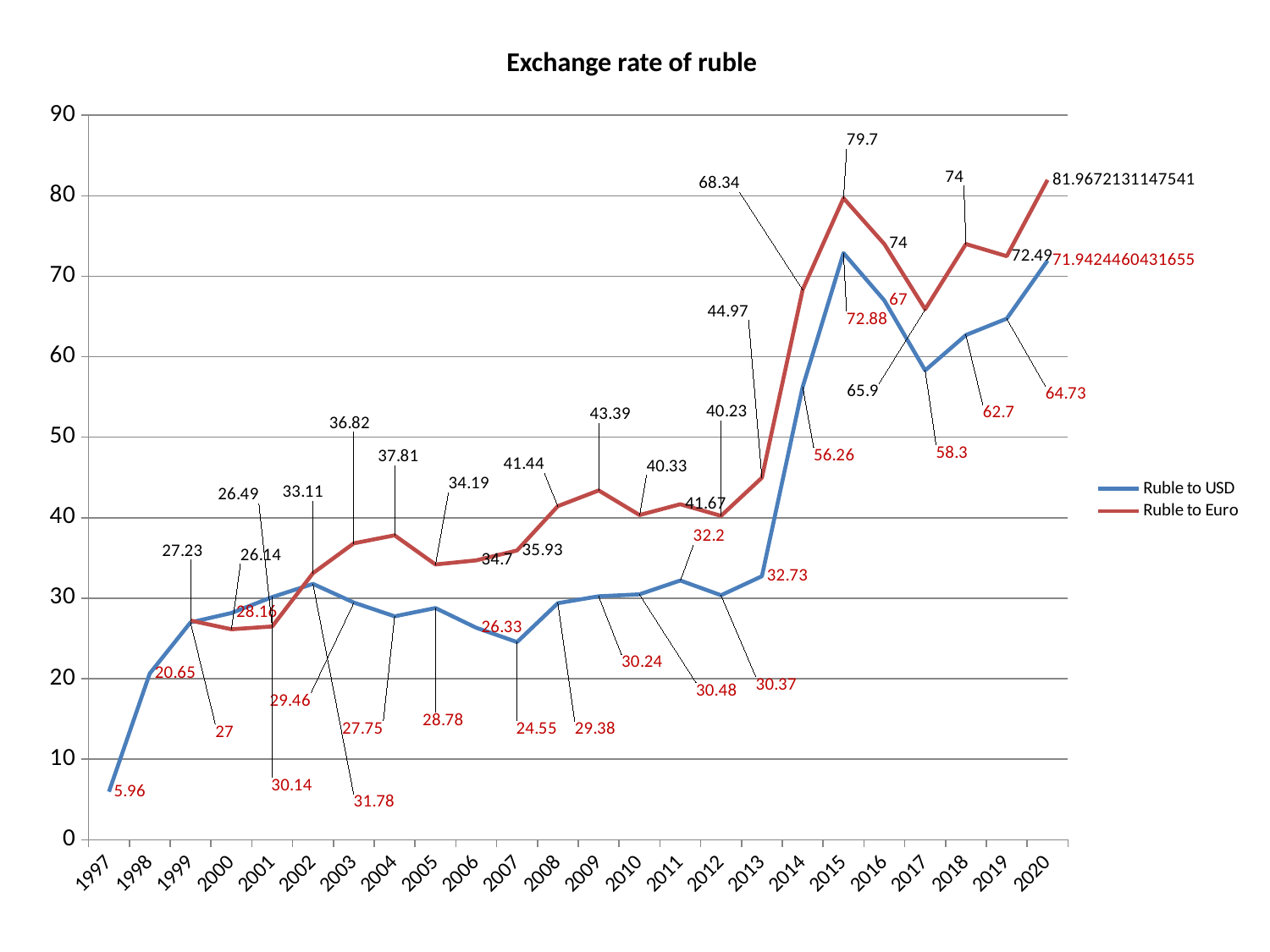
How many series does the legend list? 2 What is the Ruble to USD value for 2017? 58.3 In 2001, which series has the larger value, Ruble to USD or Ruble to Euro? Ruble to USD What is the difference between the Ruble to Euro and Ruble to USD values in 2015? 6.82 What kind of chart is shown on the slide? Line chart In which year is the Ruble to USD value lowest? 1997 What is the Ruble to Euro value for 2015? 79.7 Is the Ruble to USD value for 2014 greater or less than 50? greater What is the Ruble to Euro value for 2013? 44.97 How many years are shown on the x axis? 24 In which year is the Ruble to Euro value highest? 2020 What is the Ruble to USD value for 1997? 5.96